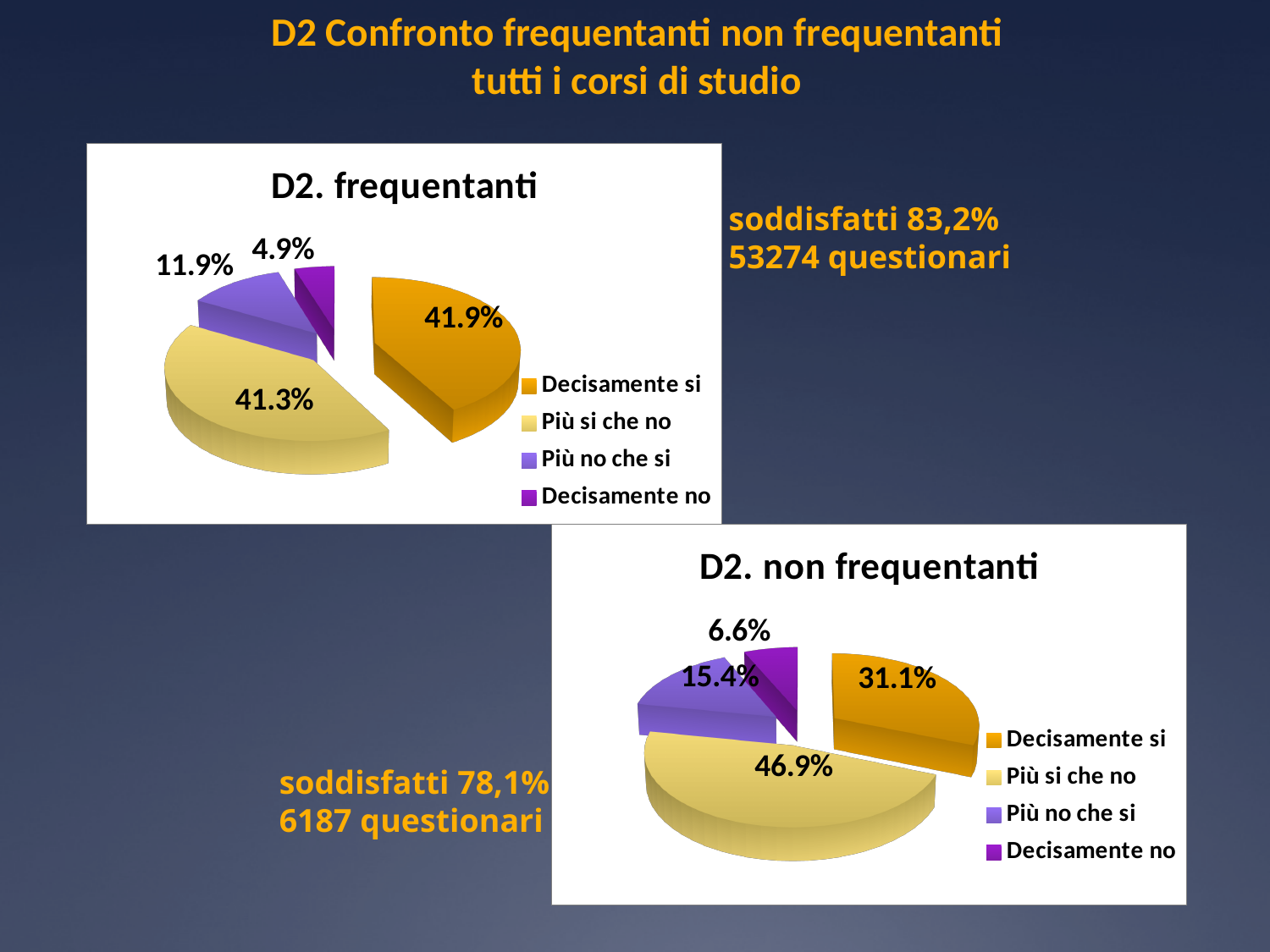
What kind of chart is "D2. non frequentanti"? Pie chart In the "D2. non frequentanti" chart, what is the value for "Più si che no"? 46.9% In the "D2. frequentanti" chart, what is the value for "Decisamente si"? 41.9% In the "D2. frequentanti" chart, which category has the smallest slice? Decisamente no In the "D2. non frequentanti" chart, what is the difference between "Più si che no" and "Decisamente si"? 15.8% In the "D2. non frequentanti" chart, which colour represents "Più no che si"? Purple (light violet) How many slices does the "D2. frequentanti" pie chart have? 4 Which is larger: "Decisamente si" in the "D2. frequentanti" chart or "Decisamente si" in the "D2. non frequentanti" chart? D2. frequentanti In the "D2. frequentanti" chart, what is the combined share of "Decisamente si" and "Più si che no"? 83.2% In the "D2. frequentanti" chart, what is the value for "Più no che si"? 11.9% In the "D2. non frequentanti" chart, which category has the largest slice? Più si che no In the "D2. non frequentanti" chart, what is the value for "Decisamente no"? 6.6%